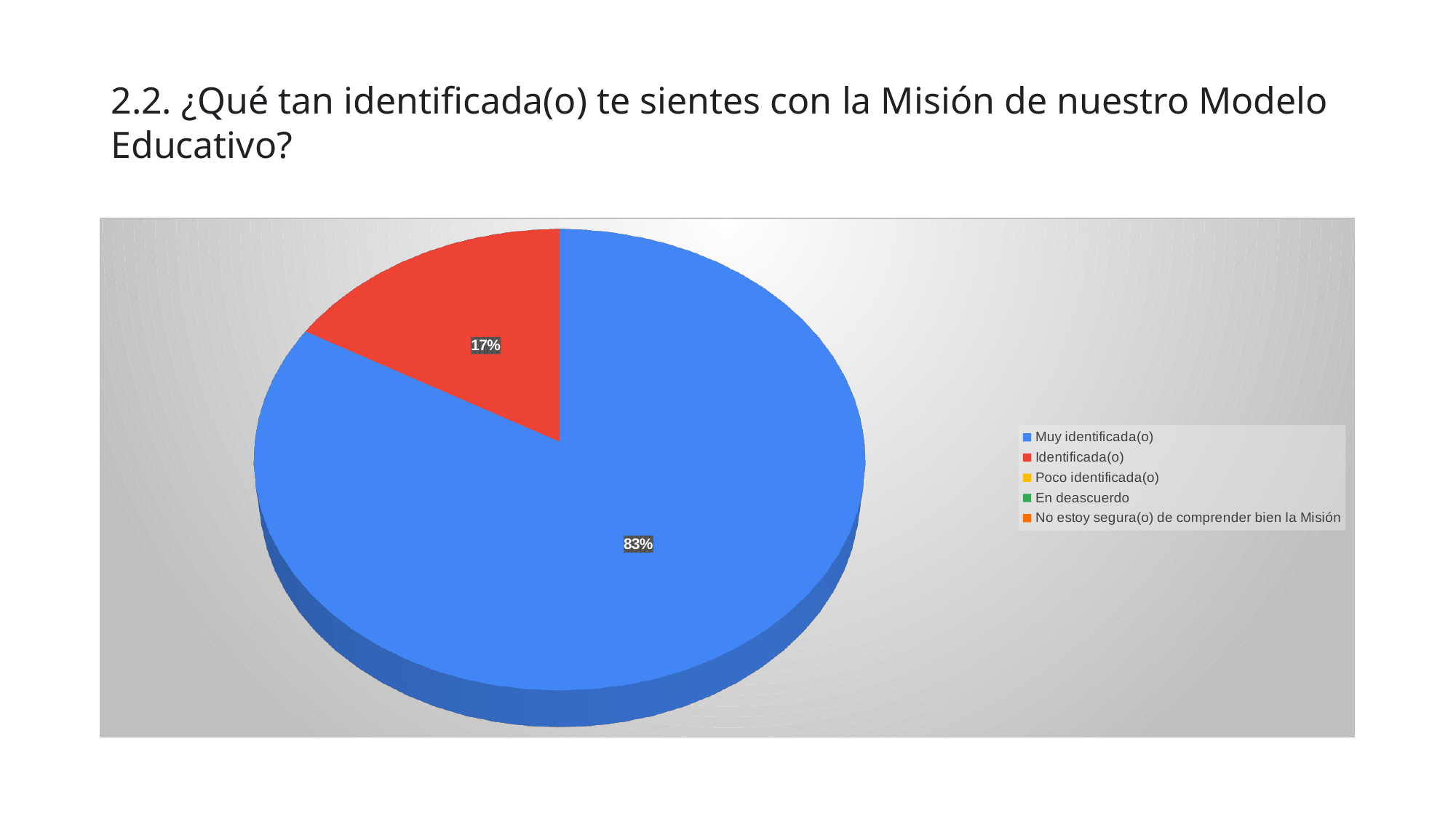
What is the difference in percentage points between the "Muy identificada(o)" slice and the "Identificada(o)" slice? 66 Which slice is larger, "Muy identificada(o)" or "Identificada(o)"? Muy identificada(o) How many slices are visible in the pie? 2 What share of the pie does "Muy identificada(o)" represent? 83% What colour is the "Muy identificada(o)" slice? Blue How many entries does the legend list? 5 What colour is the "Identificada(o)" slice? Red Which category has the largest slice of the pie? Muy identificada(o) What share of the pie does "Identificada(o)" represent? 17% What kind of chart is shown on the slide? Pie chart What is the total of the two labelled slices? 100%